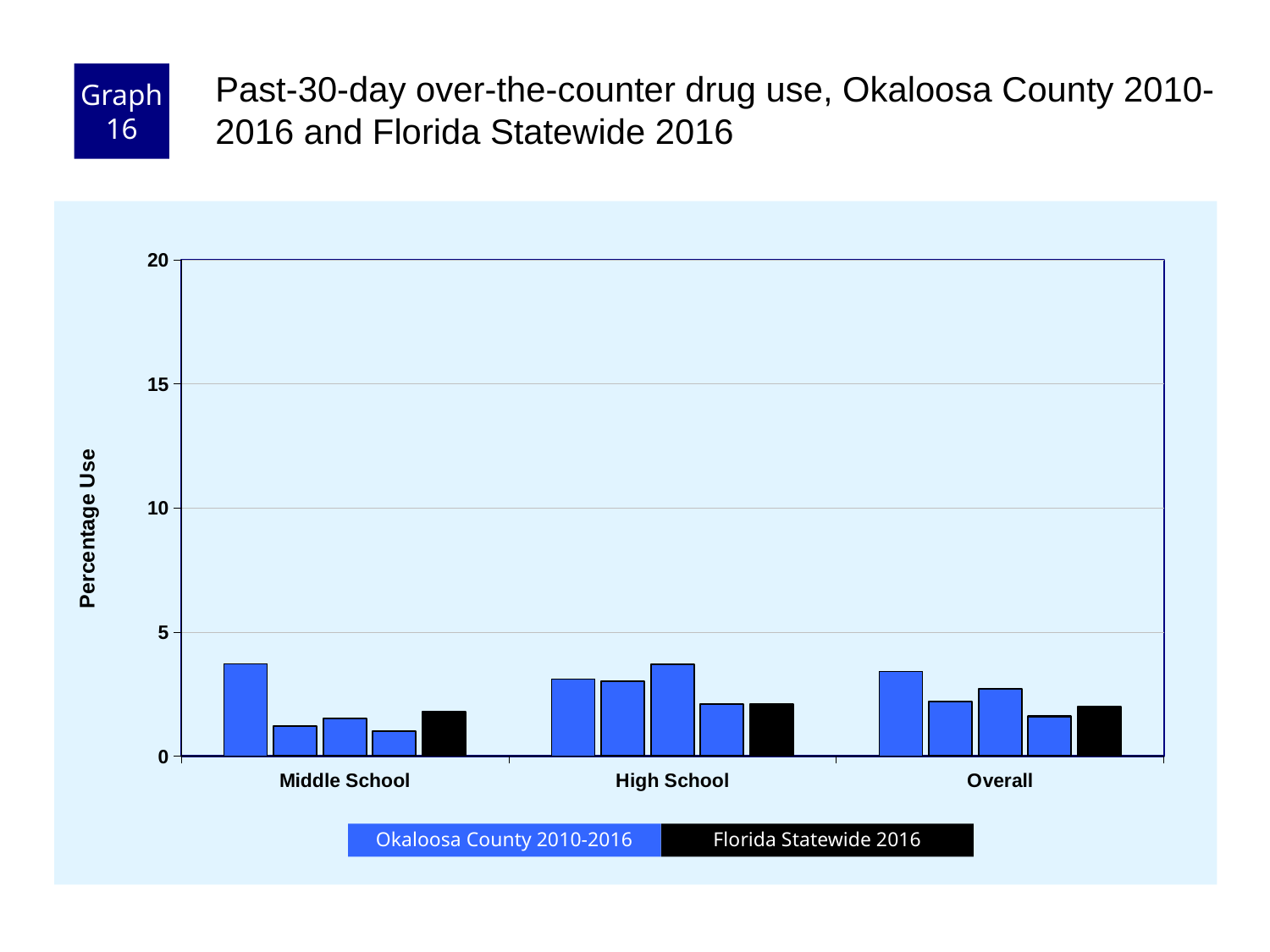
Which colour represents Florida Statewide 2016 in the legend? black What kind of chart is shown on the slide? bar chart How many categories are shown on the x axis? 3 Are any of the bars in the chart greater than 5? No Is the Florida Statewide 2016 value for Middle School greater or less than 5? less What is the highest value shown on the y axis? 20 Is the Florida Statewide 2016 value for High School greater or less than 5? less What is the label on the y axis? Percentage Use How many series does the legend list? 2